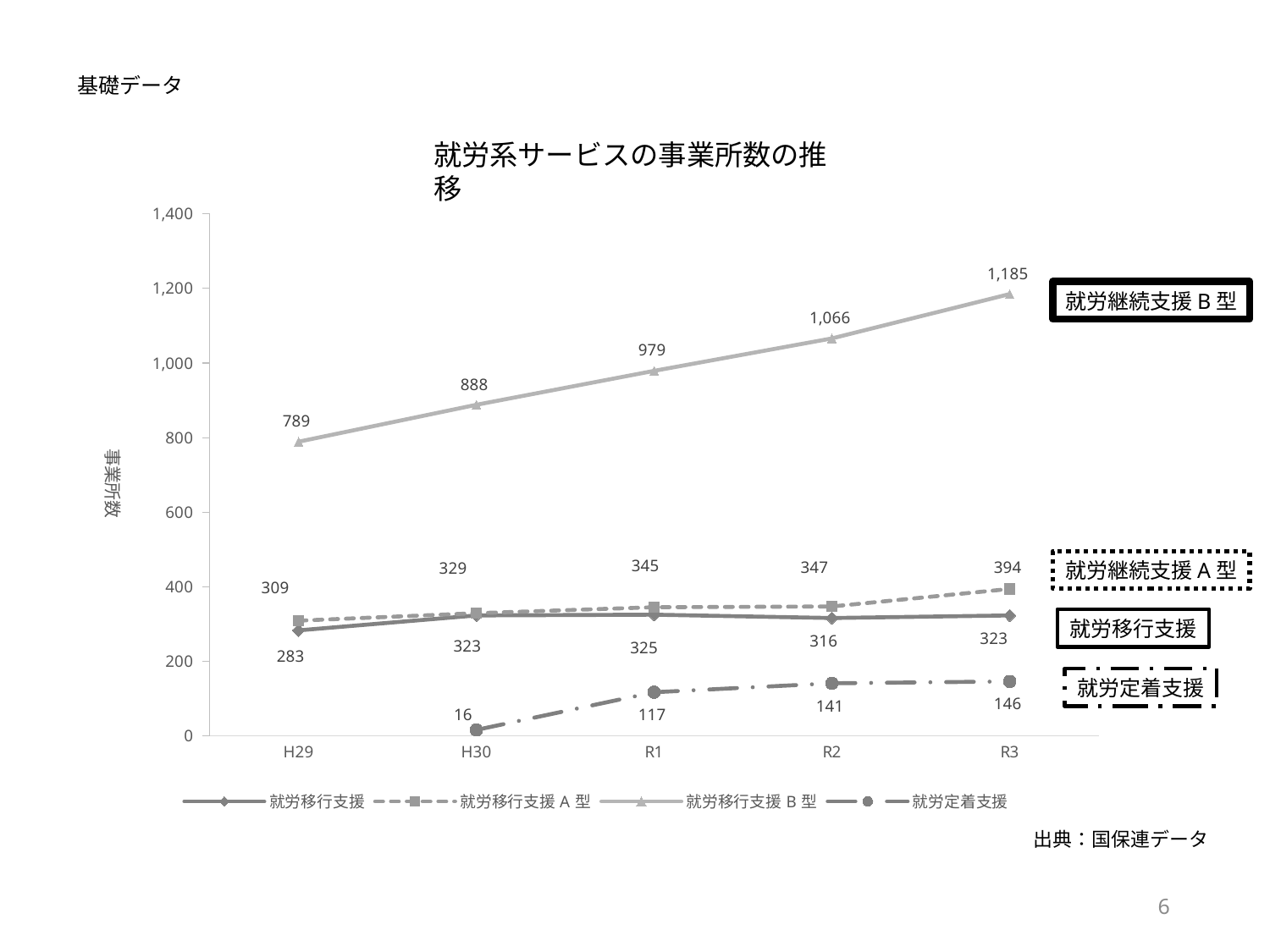
Which is larger in R2: 就労移行支援 A 型 or 就労移行支援? 就労移行支援 A 型 How many points are on the x axis? 5 What kind of chart is shown on the slide? line chart What is the difference between the 就労移行支援 B 型 values in R3 and H29? 396 What is the value for 就労移行支援 B 型 in R3? 1,185 What is the value for 就労移行支援 A 型 in H30? 329 What is the value for 就労定着支援 in R1? 117 What is the title of the chart? 就労系サービスの事業所数の推移 In which year is the value for 就労移行支援 B 型 lowest? H29 How many series does the legend list? 4 In which year is the value for 就労移行支援 A 型 highest? R3 Does the value for 就労移行支援 B 型 rise or fall from H29 to R3? rise